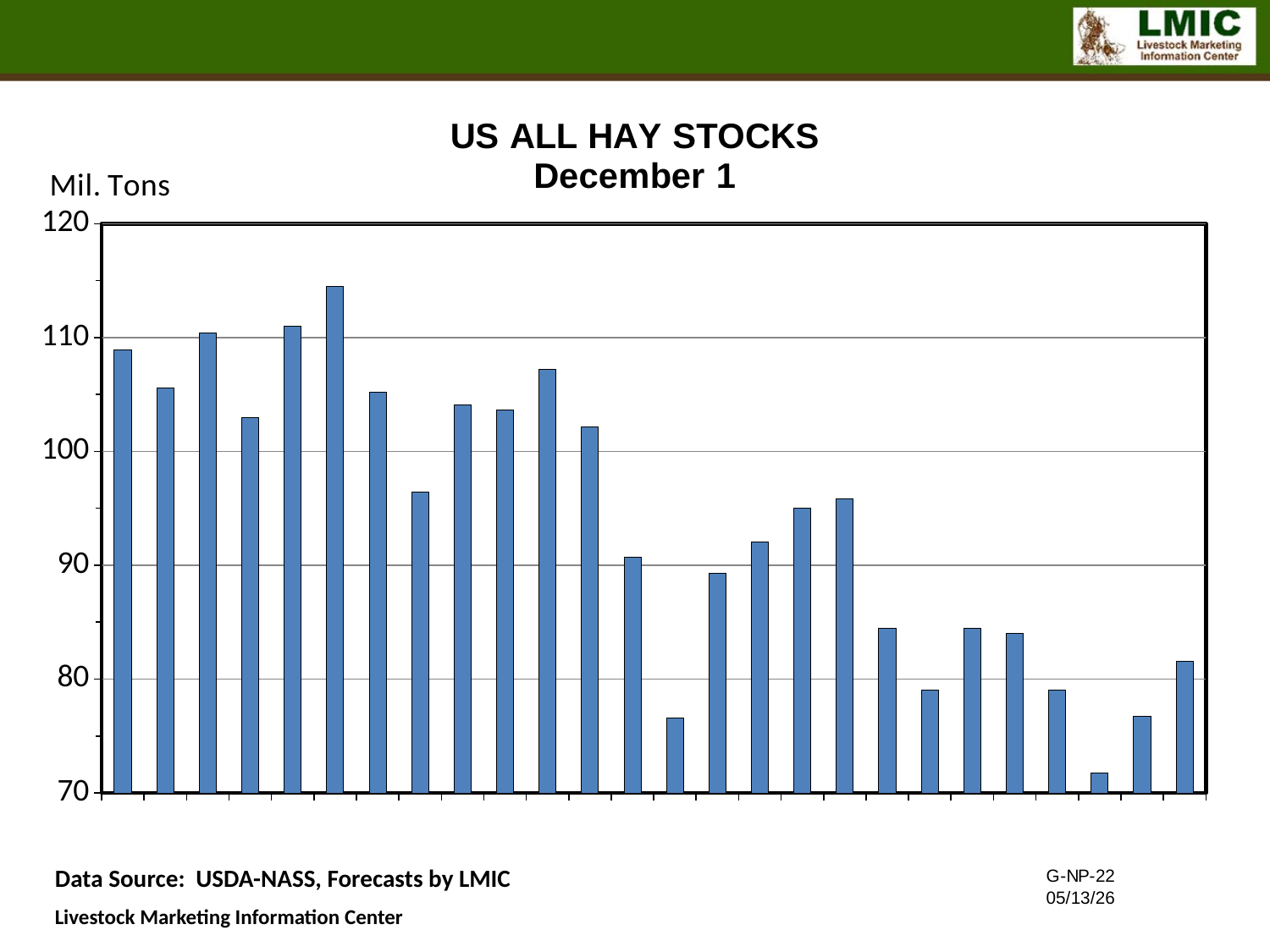
Is the value of the first (leftmost) bar greater or less than 100? greater Is the value of the shortest bar greater or less than 80? less What is the title of the chart? US ALL HAY STOCKS December 1 Do the bar values generally rise or fall from left to right across the chart? fall Which bar is the shortest in the chart, counting from the left? the 24th bar How many bars are plotted in the chart? 26 What kind of chart is shown on the slide? bar chart Is the value of the last (rightmost) bar greater or less than 90? less Which is larger, the first bar or the last bar? the first bar Which bar is the tallest in the chart, counting from the left? the 6th bar What unit is shown on the vertical axis of the chart? Mil. Tons